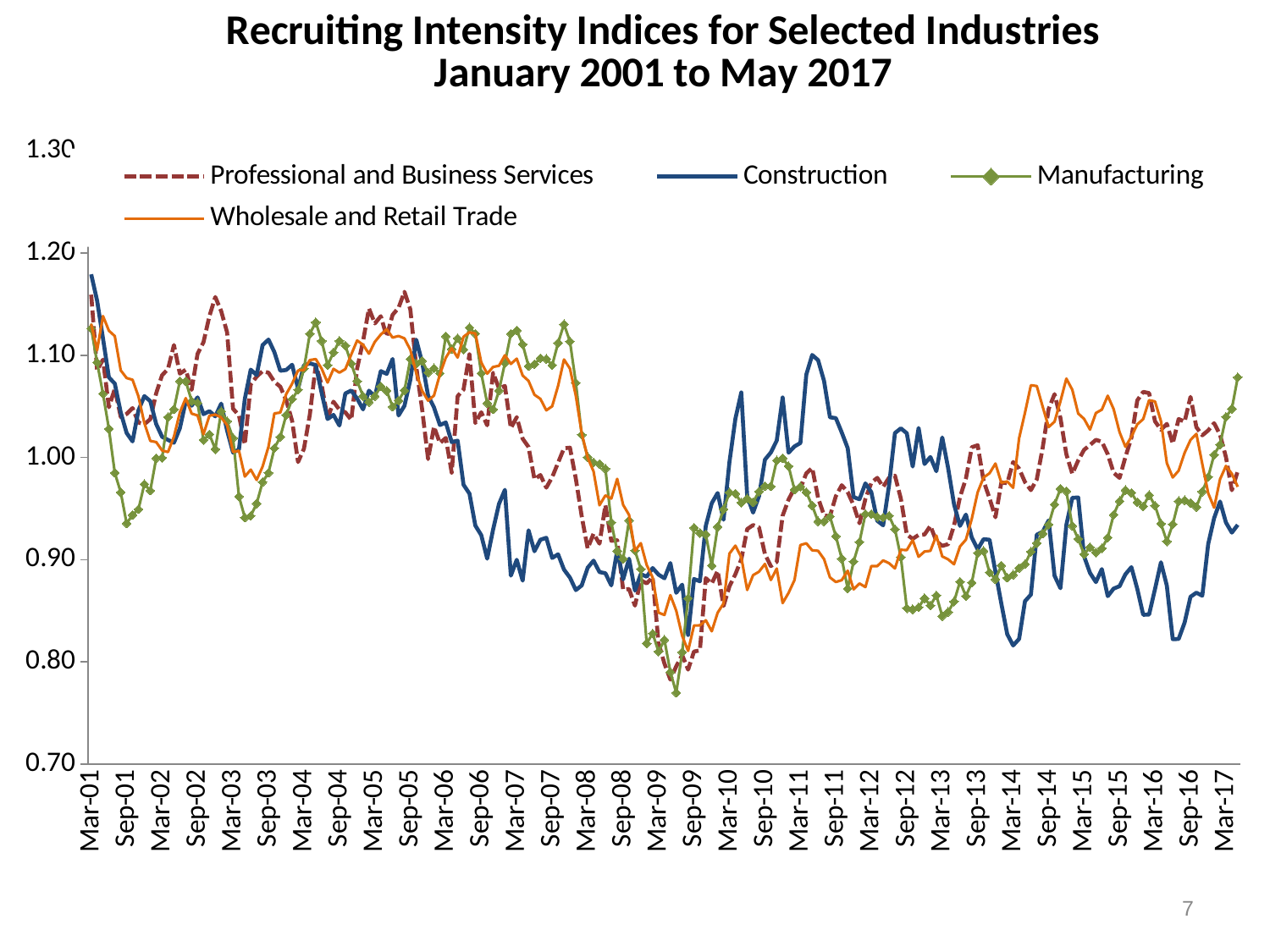
Is the value for Wholesale and Retail Trade at Sep-14 greater or less than 1.00? greater What kind of chart is shown on the slide? line chart How many series does the legend list? 4 Is the value for Construction at Mar-14 greater or less than 0.90? less Is the value for Manufacturing at Mar-17 greater or less than 1.00? greater At Mar-14, which series has the higher value: Wholesale and Retail Trade or Construction? Wholesale and Retail Trade Does the Manufacturing series rise or fall between Sep-16 and Mar-17? rise Which series is drawn with a dashed line? Professional and Business Services What is the title of the chart? Recruiting Intensity Indices for Selected Industries January 2001 to May 2017 Does the Construction series rise or fall between Mar-06 and Mar-09? fall